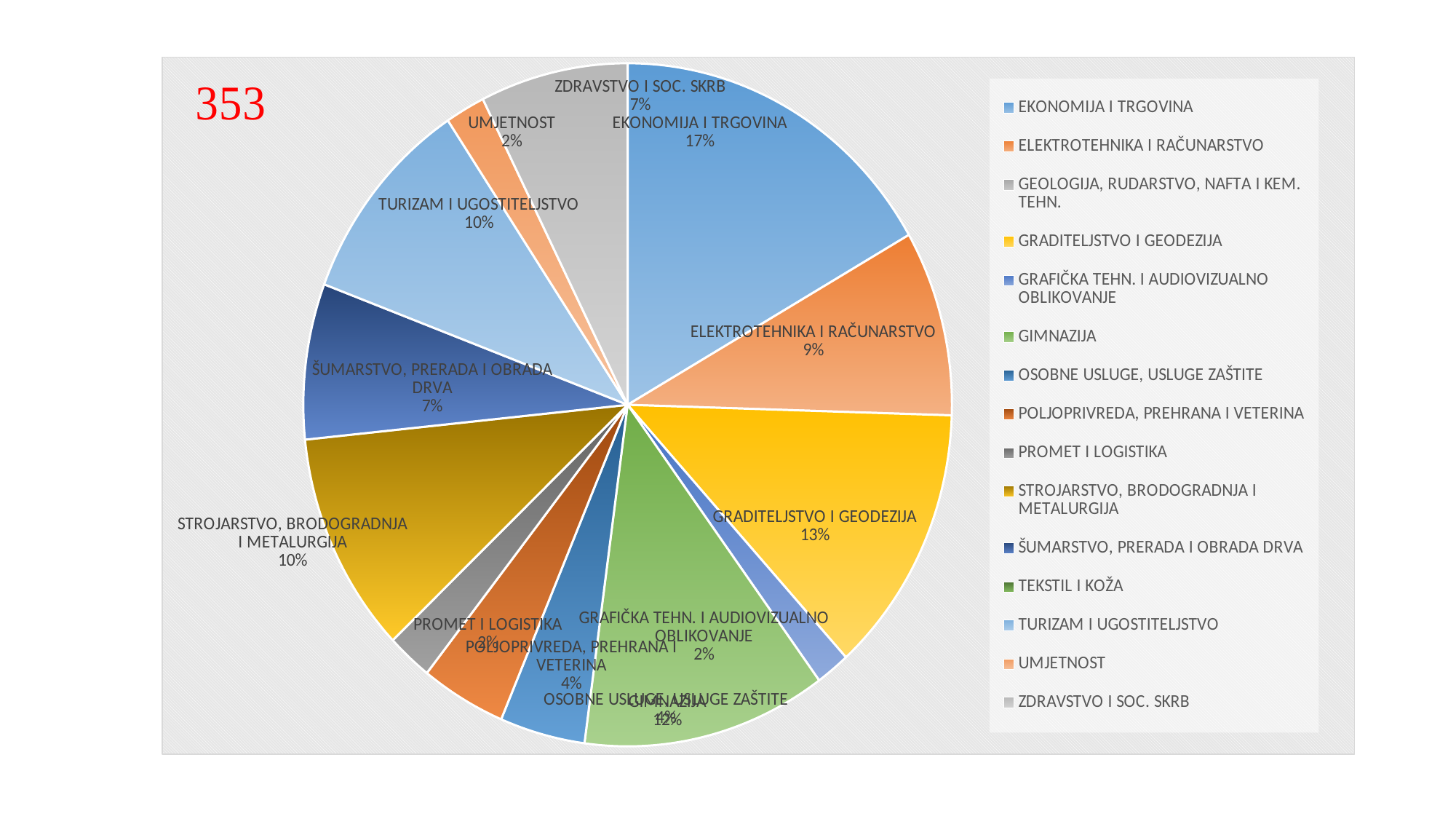
Which has the larger share, GRADITELJSTVO I GEODEZIJA or ELEKTROTEHNIKA I RAČUNARSTVO? GRADITELJSTVO I GEODEZIJA What number is printed in red in the top-left corner of the chart area? 353 What percentage share does EKONOMIJA I TRGOVINA have in the pie chart? 17% How many entries does the legend list? 15 How many percentage points larger is the share of EKONOMIJA I TRGOVINA than that of ELEKTROTEHNIKA I RAČUNARSTVO? 8 What percentage is shown for ELEKTROTEHNIKA I RAČUNARSTVO? 9% What percentage is shown for GRADITELJSTVO I GEODEZIJA? 13% What percentage is shown for TURIZAM I UGOSTITELJSTVO? 10% What percentage is shown for UMJETNOST? 2% What percentage is shown for ŠUMARSTVO, PRERADA I OBRADA DRVA? 7% Which category has the largest share of the pie? EKONOMIJA I TRGOVINA What kind of chart is shown on the slide? pie chart